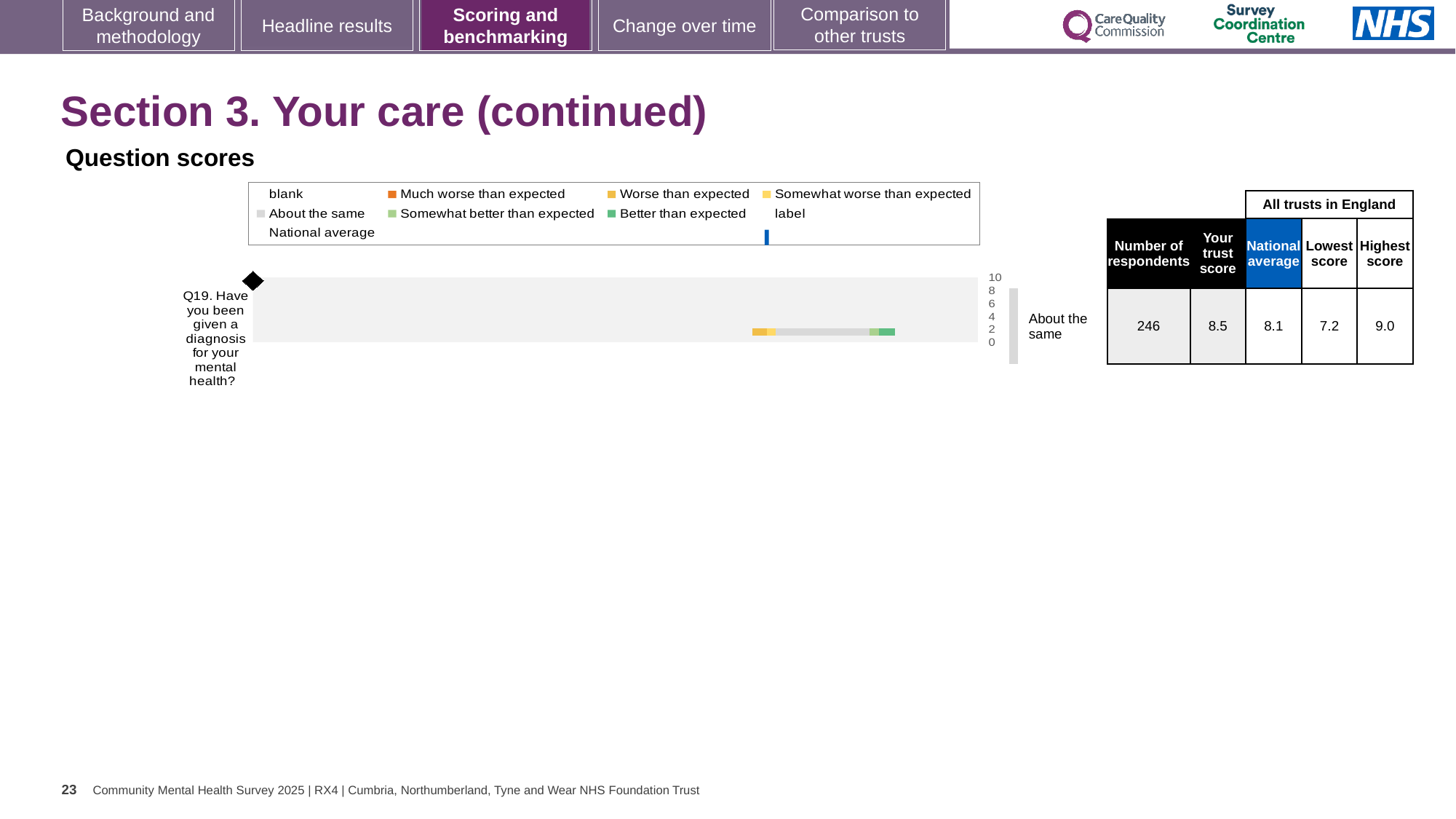
What benchmark category is shown for Q19? About the same How many respondents answered Q19? 246 Which is larger for Q19, the trust score or the national average? the trust score What is the national average score for Q19? 8.1 What is the maximum value shown on the chart's score axis? 10 What is the difference between the highest and lowest scores for Q19 across all trusts in England? 1.8 What is the highest score among all trusts in England for Q19? 9.0 How many questions are plotted on the chart? 1 By how much does the trust score for Q19 exceed the national average? 0.4 What is the trust score for Q19 (Have you been given a diagnosis for your mental health?)? 8.5 What is the lowest score among all trusts in England for Q19? 7.2 What kind of chart is used to show the Q19 question score? bar chart